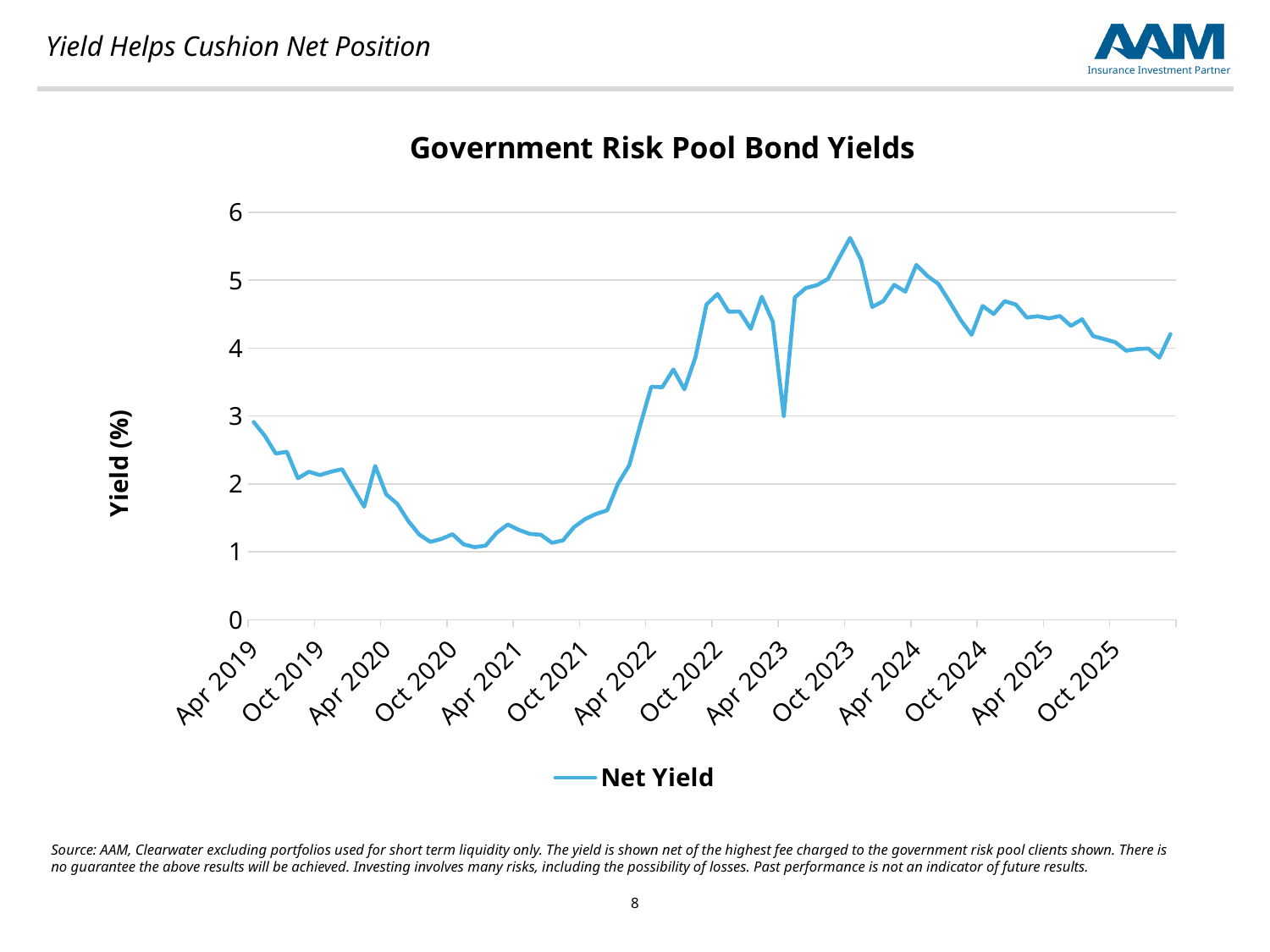
What kind of chart is shown on the slide? line chart Is the Net Yield value at Oct 2020 greater or less than 2? less Is the Net Yield value at Apr 2025 greater or less than 5? less Is the Net Yield value at Oct 2023 greater or less than 5? greater What is the title of the chart? Government Risk Pool Bond Yields Is the highest point of the Net Yield line greater or less than 5? greater Does the Net Yield rise or fall between Oct 2021 and Oct 2023? rise Is the lowest point of the Net Yield line greater or less than 2? less Which is larger, the Net Yield at Oct 2022 or at Oct 2020? Oct 2022 What is the label of the series shown in the legend? Net Yield How many series does the legend list? 1